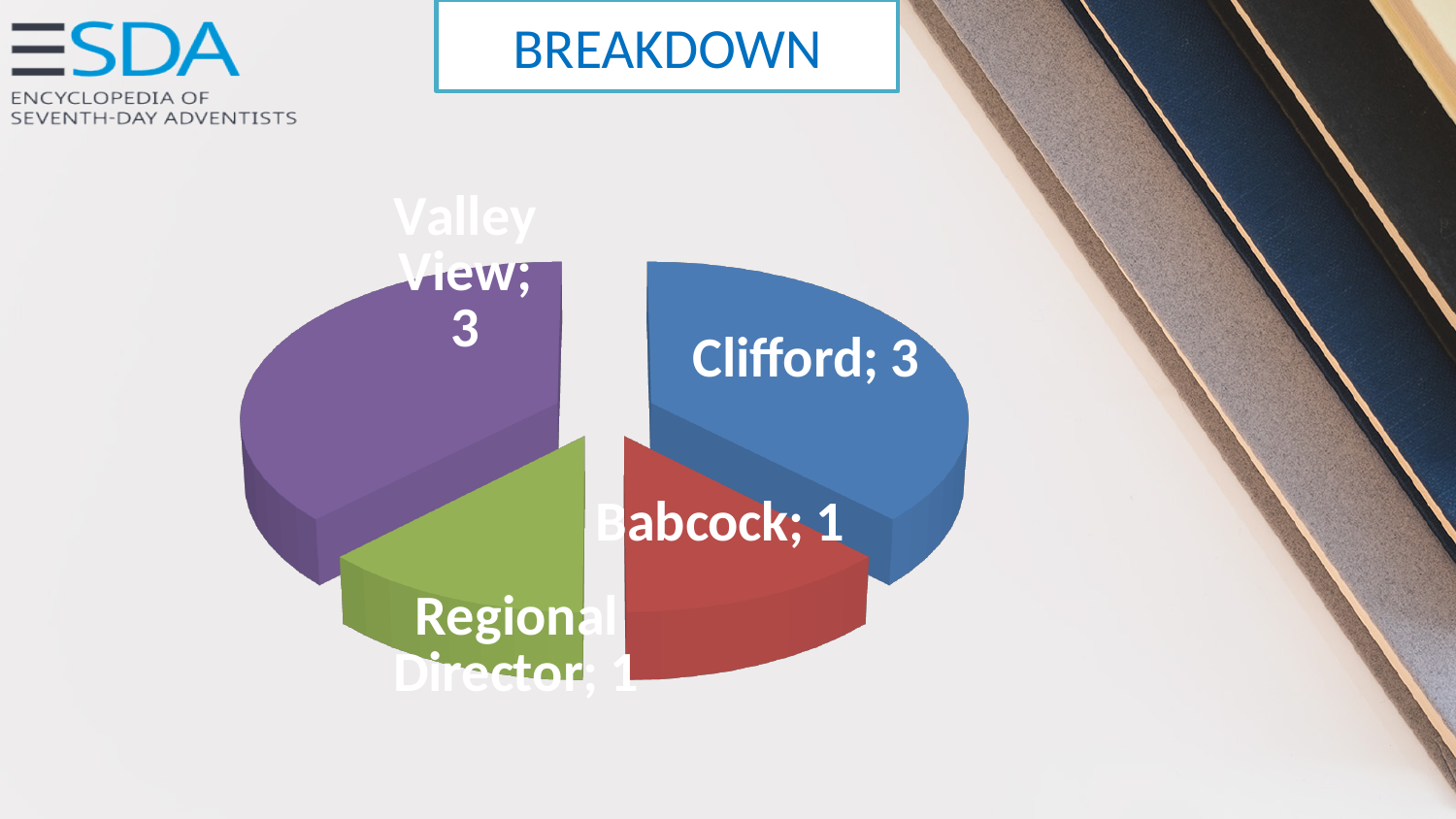
What value is shown for Regional Director in the pie chart? 1 Which is larger, the value for Valley View or the value for Regional Director? Valley View What value is shown for Clifford in the pie chart? 3 What is the difference between the values for Clifford and Babcock? 2 What value is shown for Babcock in the pie chart? 1 What is the total of all the slices in the pie chart? 8 What share of the pie does the Babcock slice represent? 12.5% What value is shown for Valley View in the pie chart? 3 What kind of chart is shown on the slide? Pie chart Which is larger, the value for Clifford or the value for Babcock? Clifford How many slices does the pie chart have? 4 What colour is the Clifford slice in the pie chart? Blue